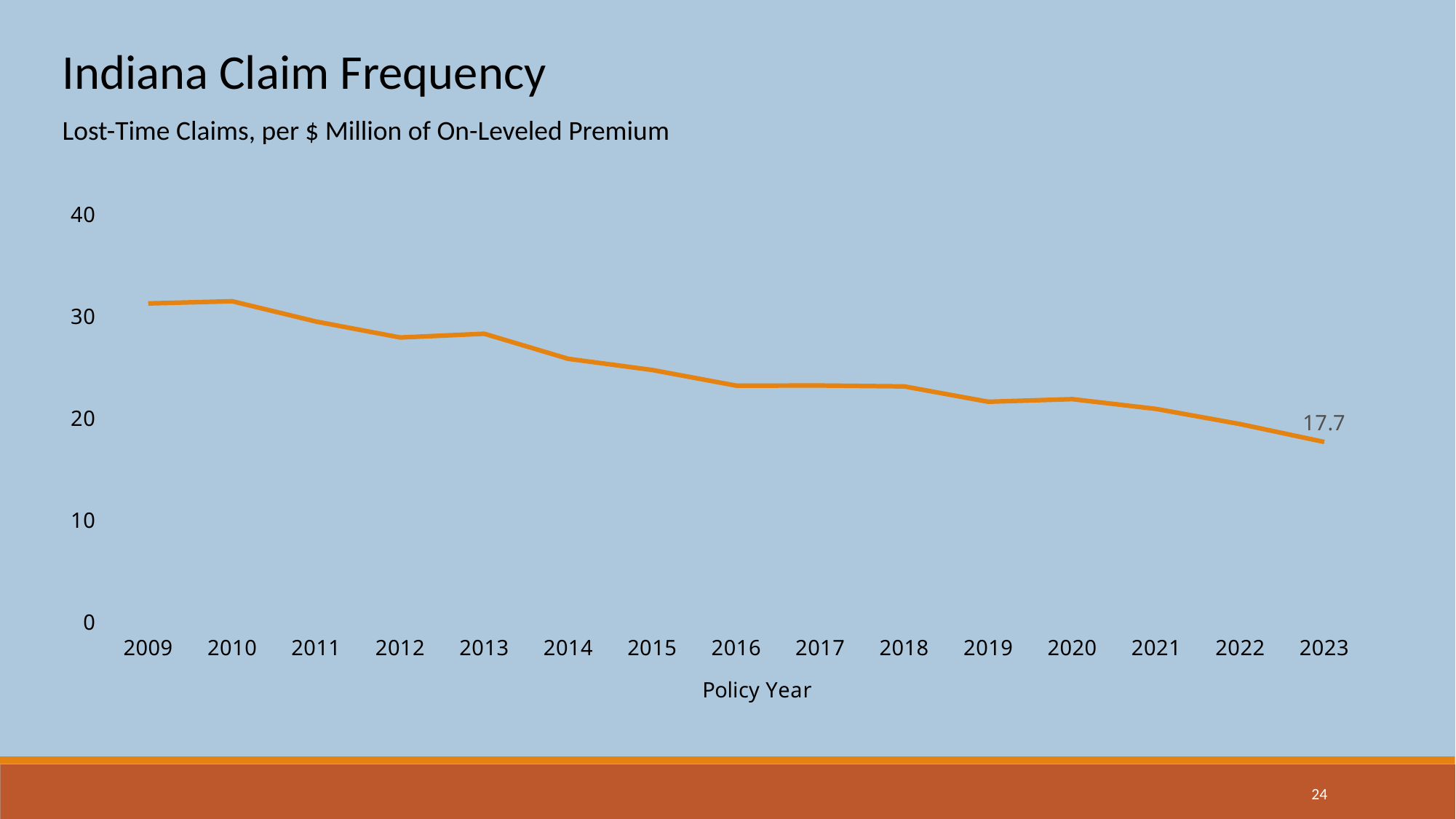
What is the title of the chart? Indiana Claim Frequency Is the value for 2016 greater or less than 30? less How many policy years are plotted on the x axis? 15 What is the label of the x axis? Policy Year Do the values generally rise or fall from 2009 to 2023? fall What is the value for 2023? 17.7 Which policy year has the lowest value? 2023 Is the value for 2009 greater or less than 30? greater Which is larger, the value for 2012 or the value for 2019? 2012 Is the value for 2023 greater or less than 20? less Which policy year has the highest value? 2010 What kind of chart is shown on the slide? line chart